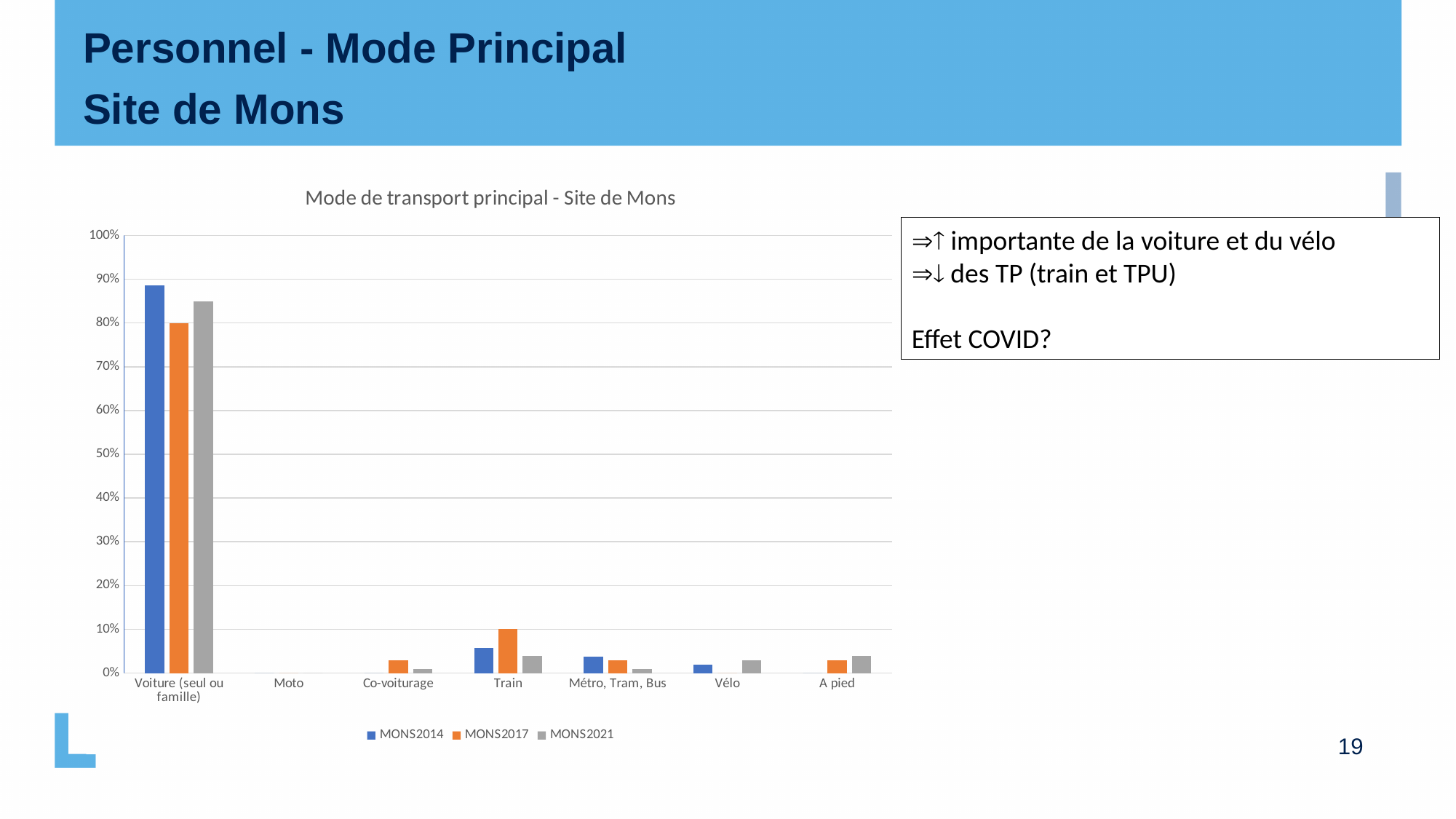
How many series does the legend list? 3 Is the MONS2014 value for Voiture (seul ou famille) greater or less than 80%? greater What kind of chart is shown on the slide? bar chart For Voiture (seul ou famille), which is larger: the MONS2014 value or the MONS2017 value? MONS2014 Which category has the highest values across all series? Voiture (seul ou famille) How many transport mode categories are shown on the x axis? 7 Is the MONS2017 value for Train greater or less than 5%? greater What is the title of the chart? Mode de transport principal - Site de Mons What are the three series listed in the legend? MONS2014, MONS2017, MONS2021 Is the MONS2021 value for Voiture (seul ou famille) greater or less than 90%? less For Train, which is larger: the MONS2017 value or the MONS2021 value? MONS2017 Which category shows no visible bars for any series? Moto